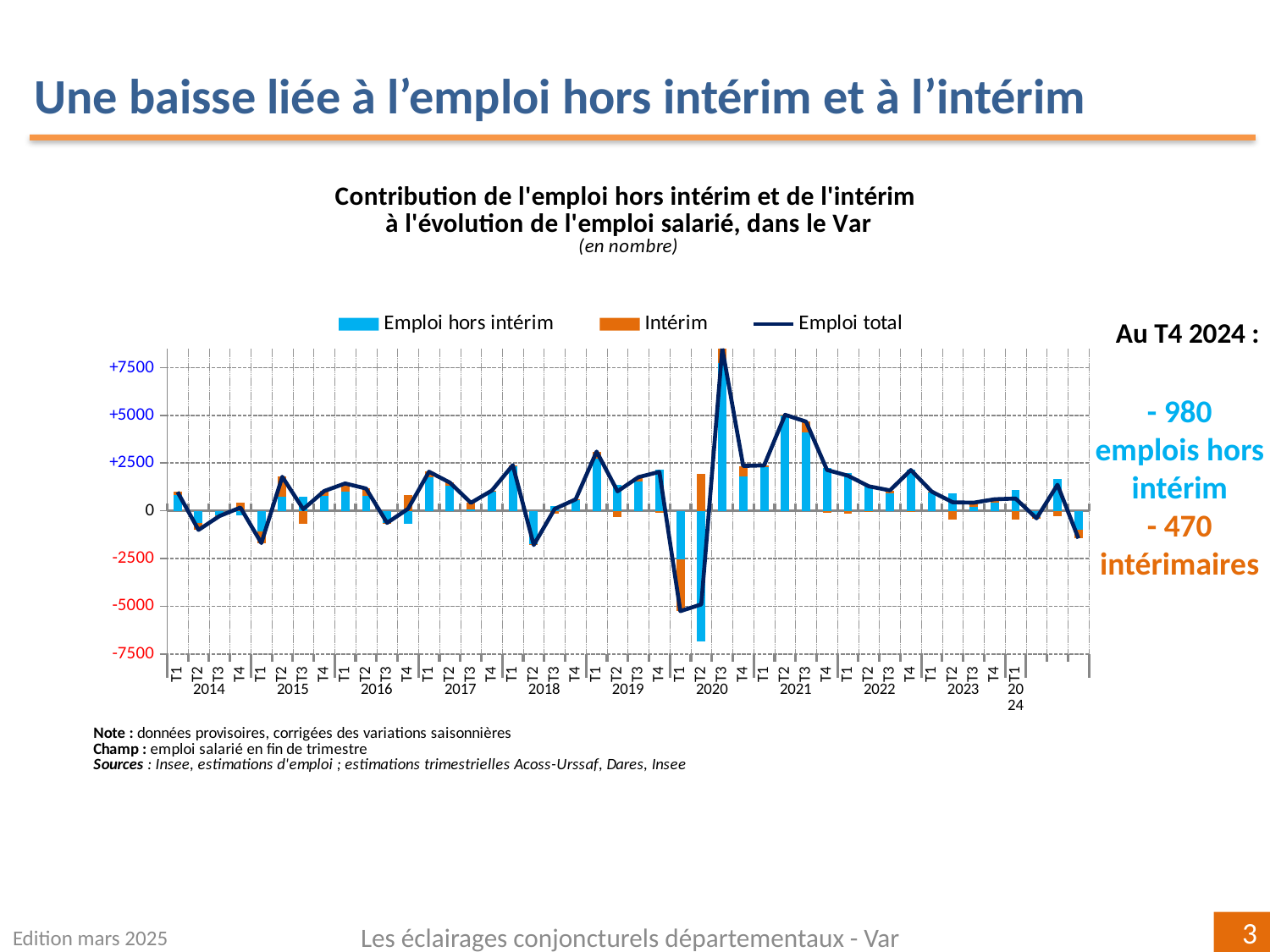
Which is larger at T4 2024: the decline in 'Emploi hors intérim' (- 980) or the decline in 'Intérim' (- 470)? Emploi hors intérim (- 980) What kind of chart is shown on the slide? A combined bar and line chart How many series does the chart legend list? 3 In which quarter does the 'Emploi total' line reach its lowest point? T1 2020 According to the slide's annotation, what is the value for 'Emploi hors intérim' at T4 2024? - 980 Is the value of 'Emploi hors intérim' at T3 2020 greater or less than +5000? greater Is the value of 'Emploi hors intérim' at T2 2020 greater or less than -5000? less How many years are labelled on the x axis of the chart? 11 In which quarter does the 'Emploi hors intérim' bar reach its lowest value? T2 2020 Which series is drawn as a dark navy line rather than bars? Emploi total According to the slide's annotation, what is the value for 'Intérim' (intérimaires) at T4 2024? - 470 In which quarter does the 'Emploi hors intérim' bar reach its highest value? T3 2020